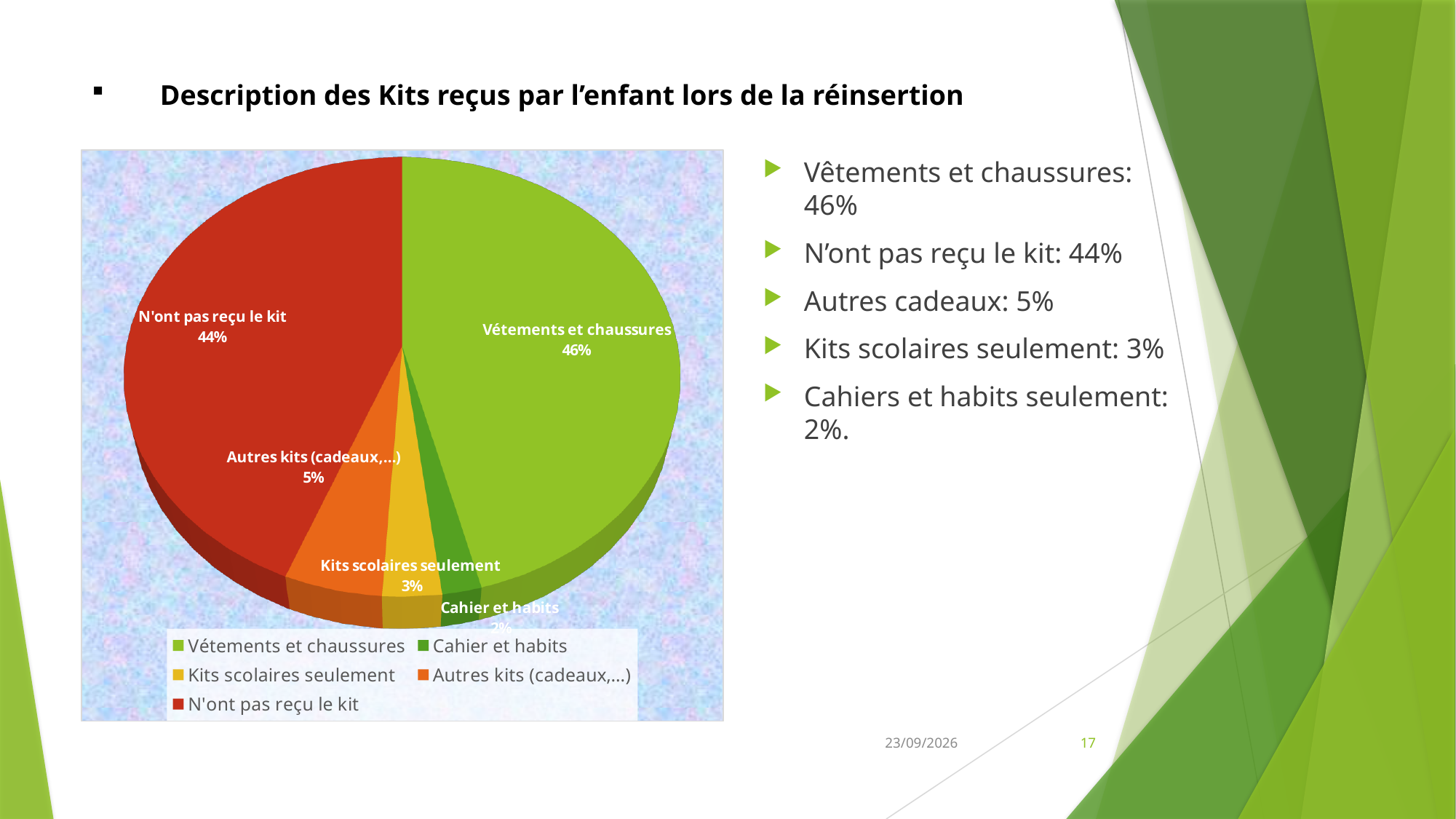
What percentage of the pie is 'Kits scolaires seulement'? 3% What colour is the 'N'ont pas reçu le kit' slice? Red What percentage of the pie is 'Vêtements et chaussures'? 46% Which category has the largest share of the pie? Vêtements et chaussures What percentage of the pie is 'Cahier et habits'? 2% How many categories does the pie chart have? 5 What is the difference in percentage points between 'Vêtements et chaussures' and 'N'ont pas reçu le kit'? 2 percentage points What type of chart is shown on the slide? Pie chart Which is larger: 'Autres kits (cadeaux,...)' or 'Kits scolaires seulement'? Autres kits (cadeaux,...) What percentage of the pie is 'Autres kits (cadeaux,...)'? 5% Which category has the smallest share of the pie? Cahier et habits What percentage of the pie is 'N'ont pas reçu le kit'? 44%